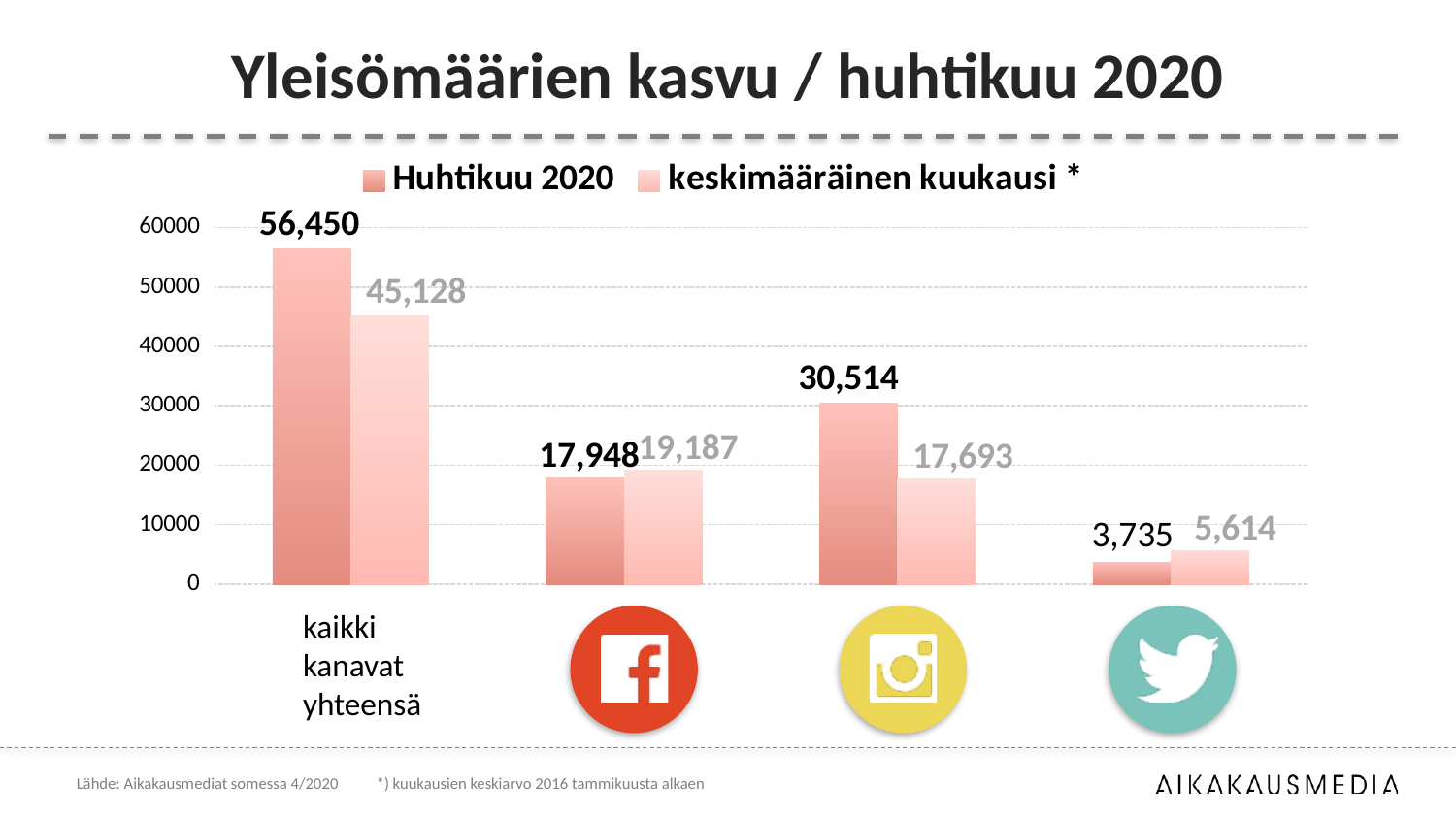
What is the keskimääräinen kuukausi value for the Twitter category? 5,614 What is the value for "kaikki kanavat yhteensä" in the keskimääräinen kuukausi series? 45,128 What is the Huhtikuu 2020 value for the Instagram category? 30,514 How many categories are shown on the x axis? 4 For the Facebook category, which is larger: the Huhtikuu 2020 value or the keskimääräinen kuukausi value? keskimääräinen kuukausi Which category has the highest keskimääräinen kuukausi value? kaikki kanavat yhteensä What is the value for "kaikki kanavat yhteensä" in the Huhtikuu 2020 series? 56,450 Which category has the lowest Huhtikuu 2020 value? Twitter How many series does the legend list? 2 What kind of chart is shown on the slide? bar chart What is the title of the slide? Yleisömäärien kasvu / huhtikuu 2020 What is the difference between the Huhtikuu 2020 and keskimääräinen kuukausi values for Instagram? 12,821